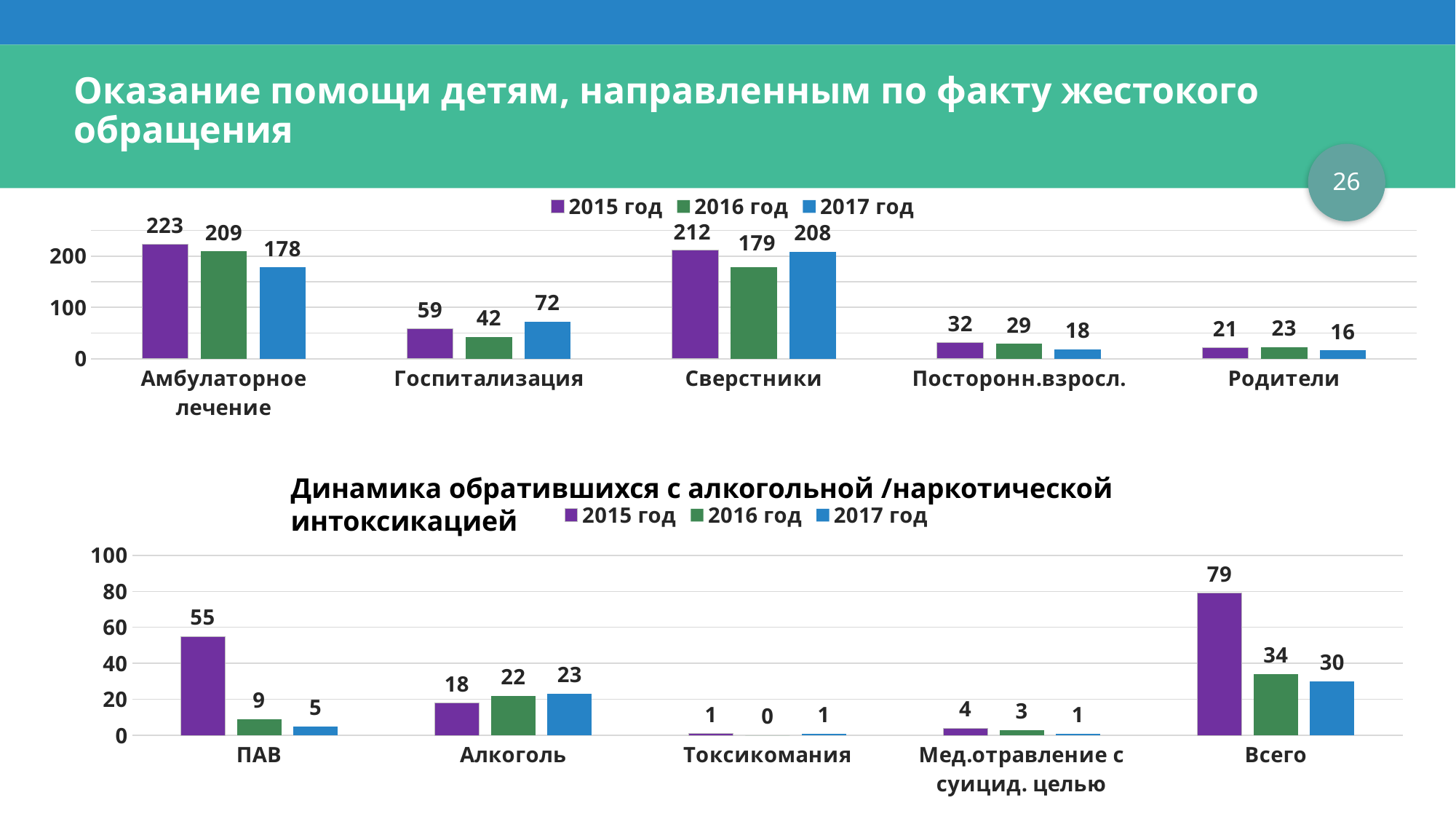
In the top chart, which is larger for Сверстники: the 2016 год value or the 2017 год value? 2017 год In the top chart, how many series does the legend list? 3 In the chart titled 'Динамика обратившихся с алкогольной /наркотической интоксикацией', what is the value for ПАВ in 2015 год? 55 In the top chart, what is the value for Госпитализация in 2017 год? 72 In the top chart, what is the difference between the 2015 год and 2017 год values for Амбулаторное лечение? 45 In the chart titled 'Динамика обратившихся с алкогольной /наркотической интоксикацией', which category has the highest value for 2015 год? Всего In the top chart, how many categories are shown on the x axis? 5 In the top chart, which category has the lowest value for 2017 год? Родители In the top chart, what is the value for Амбулаторное лечение in 2015 год? 223 In the chart titled 'Динамика обратившихся с алкогольной /наркотической интоксикацией', what is the difference between the 2015 год and 2016 год values for Всего? 45 In the chart titled 'Динамика обратившихся с алкогольной /наркотической интоксикацией', what is the value for Токсикомания in 2016 год? 0 What kind of chart is the chart titled 'Динамика обратившихся с алкогольной /наркотической интоксикацией'? Bar chart